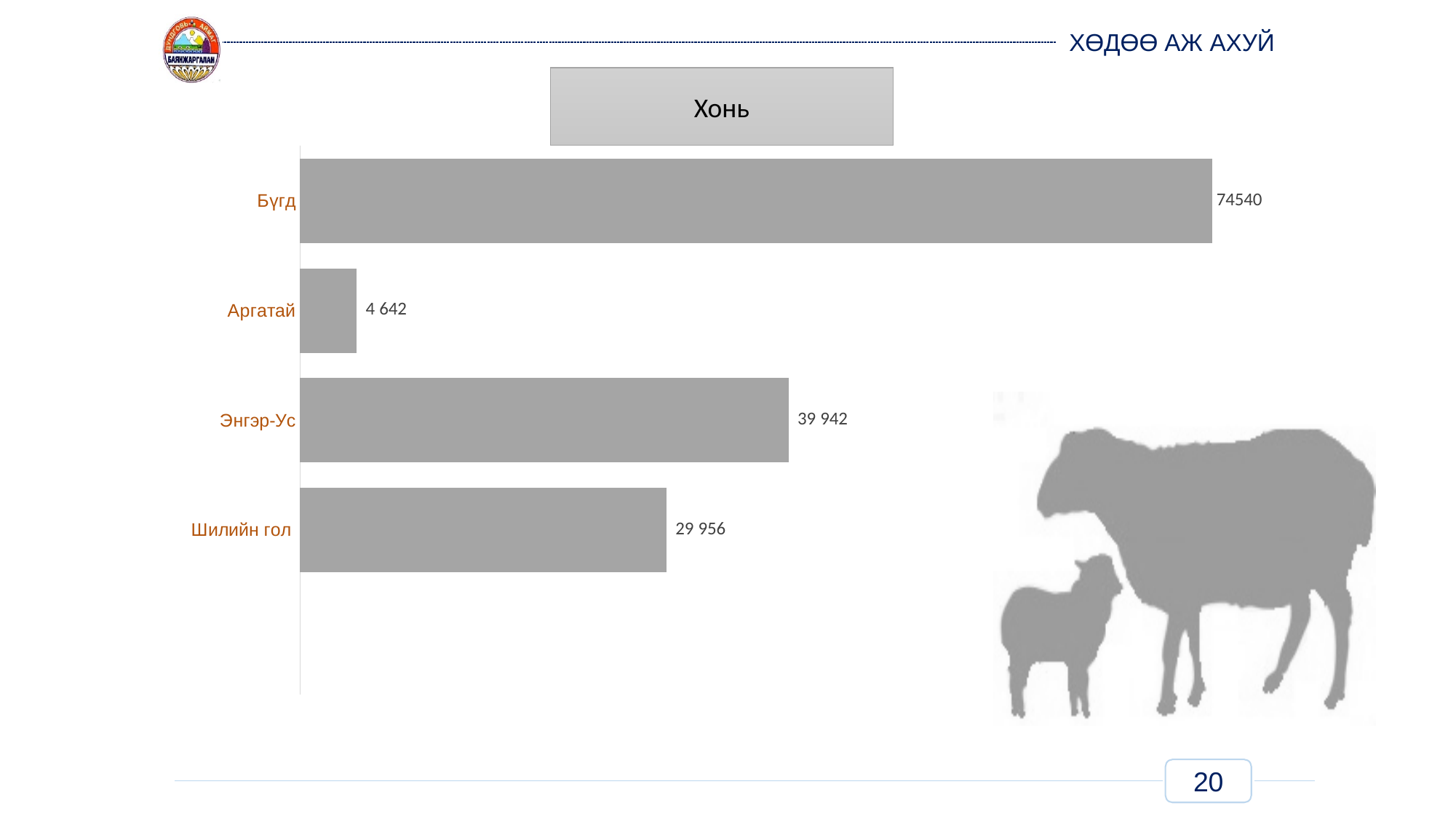
Which is larger, the value for Энгэр-Ус or the value for Шилийн гол? Энгэр-Ус What is the value for Шилийн гол? 29 956 What is the value for Аргатай? 4 642 What kind of chart is shown on the slide? bar chart What is the title of the chart? Хонь What is the difference between the values for Энгэр-Ус and Шилийн гол? 9 986 How many categories are shown in the chart? 4 What is the value for Энгэр-Ус? 39 942 What is the value for Бүгд? 74540 Which category has the lowest value? Аргатай What is the difference between the values for Энгэр-Ус and Аргатай? 35 300 Which category has the highest value? Бүгд